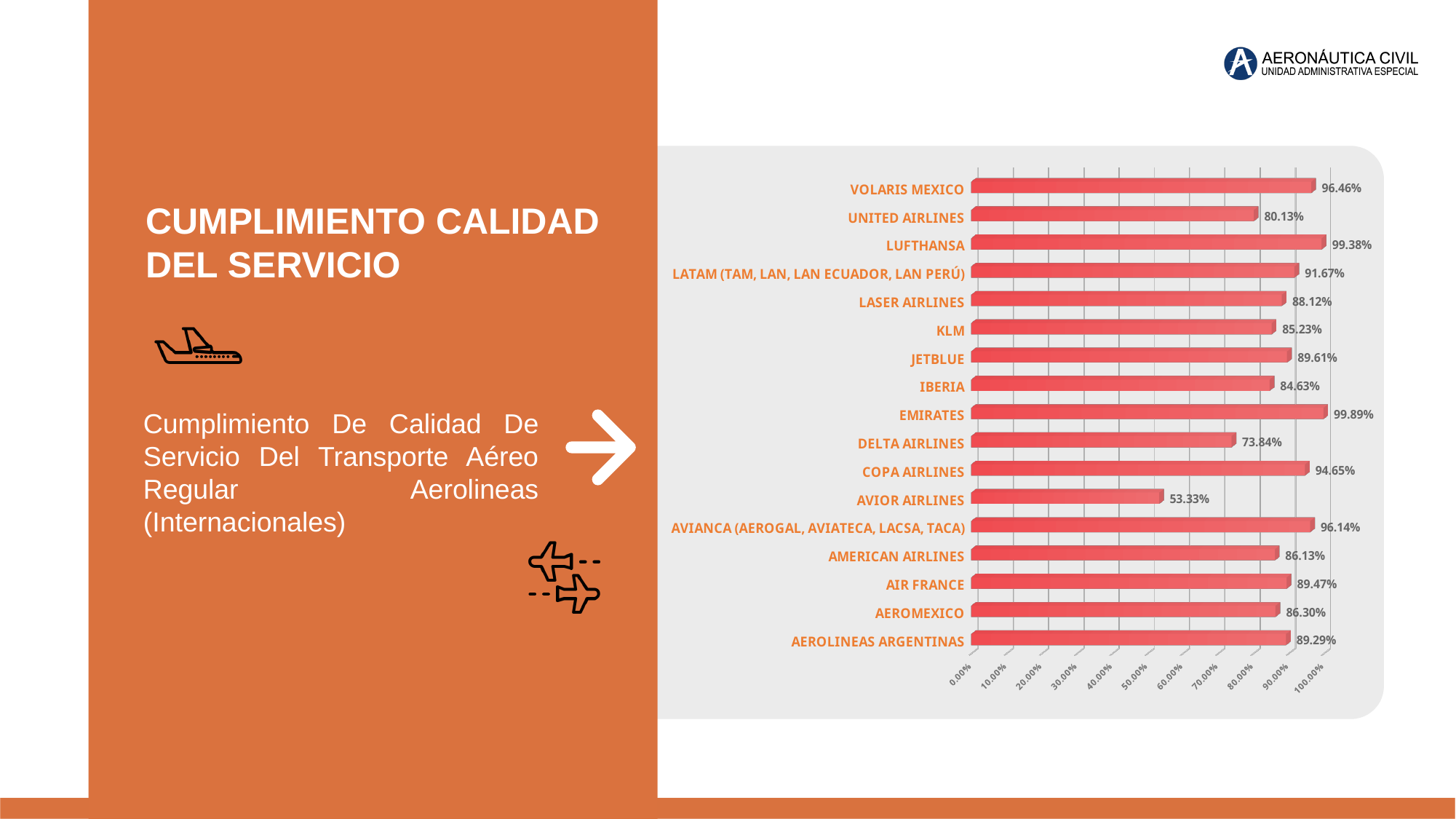
What is the value for EMIRATES? 99.89% Is the value for AVIOR AIRLINES greater or less than 60.00%? less What is the value for KLM? 85.23% What is the value for AVIOR AIRLINES? 53.33% Which airline has the highest value? EMIRATES Which airline has the lowest value? AVIOR AIRLINES Which has a larger value, DELTA AIRLINES or IBERIA? IBERIA What is the maximum value shown on the x axis of the chart? 100.00% What is the value for COPA AIRLINES? 94.65% What is the difference between the values for LUFTHANSA and UNITED AIRLINES? 19.25% What kind of chart is shown on the slide? bar chart How many airlines are shown in the chart? 17